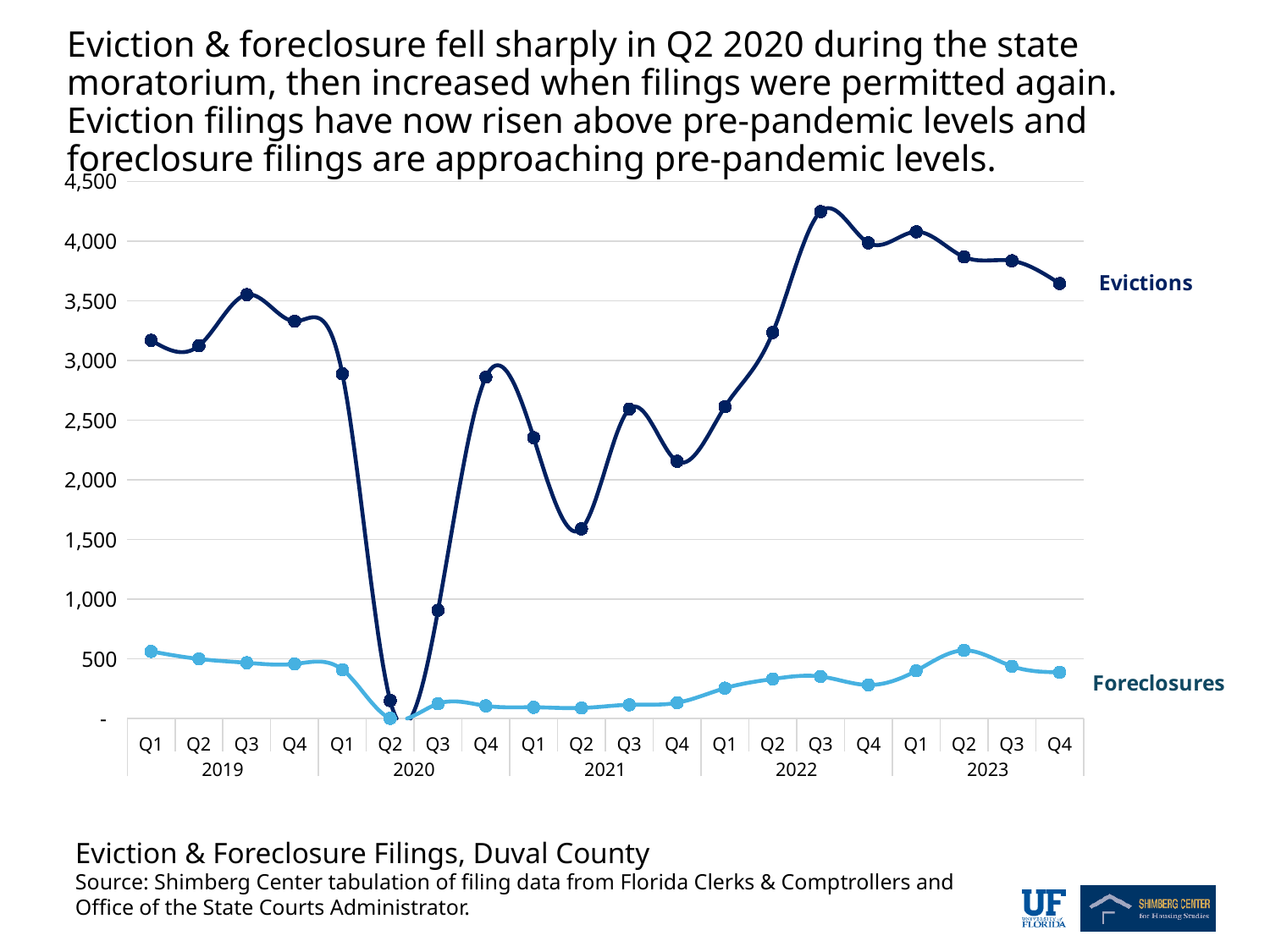
Is the Foreclosures value for Q4 2021 greater or less than 500? less Is the Evictions value for Q3 2022 greater or less than 4,000? greater In which quarter does the Evictions line reach its lowest value? Q2 2020 Do Evictions rise or fall from Q3 2022 to Q4 2023? fall Is the Evictions value for Q2 2020 greater or less than 500? less Which is higher for Evictions: Q3 2019 or Q1 2019? Q3 2019 How many series are plotted on the chart? 2 What kind of chart is shown on the slide? line chart What is the title of the chart shown below the plot? Eviction & Foreclosure Filings, Duval County In which quarter does the Evictions line reach its highest value? Q3 2022 How many quarterly data points does each line have? 20